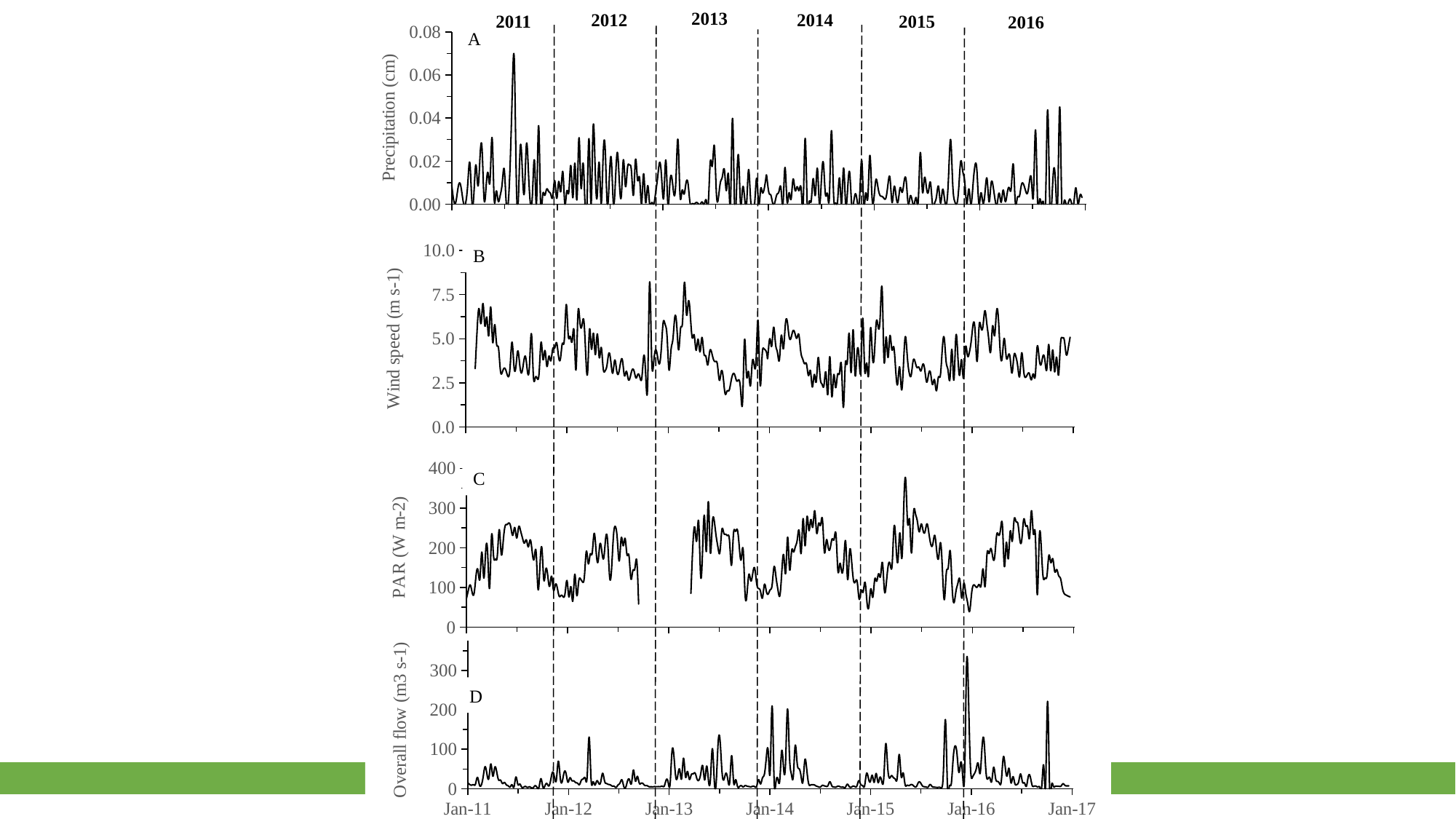
What is the y-axis label of panel D? Overall flow (m3 s-1) What is the y-axis label of panel C? PAR (W m-2) In panel A (Precipitation), is the highest peak greater or less than 0.06? greater In panel B (Wind speed), is the highest peak greater or less than 7.5? greater How many chart panels are stacked on the slide? 4 In panel B (Wind speed), is the highest peak greater or less than 10.0? less How many years are labelled along the top of the charts? 6 In panel C (PAR), in which labelled year does the highest peak occur? 2015 In panel A (Precipitation), in which labelled year does the highest peak occur? 2011 What kind of chart is panel A (Precipitation)? line chart